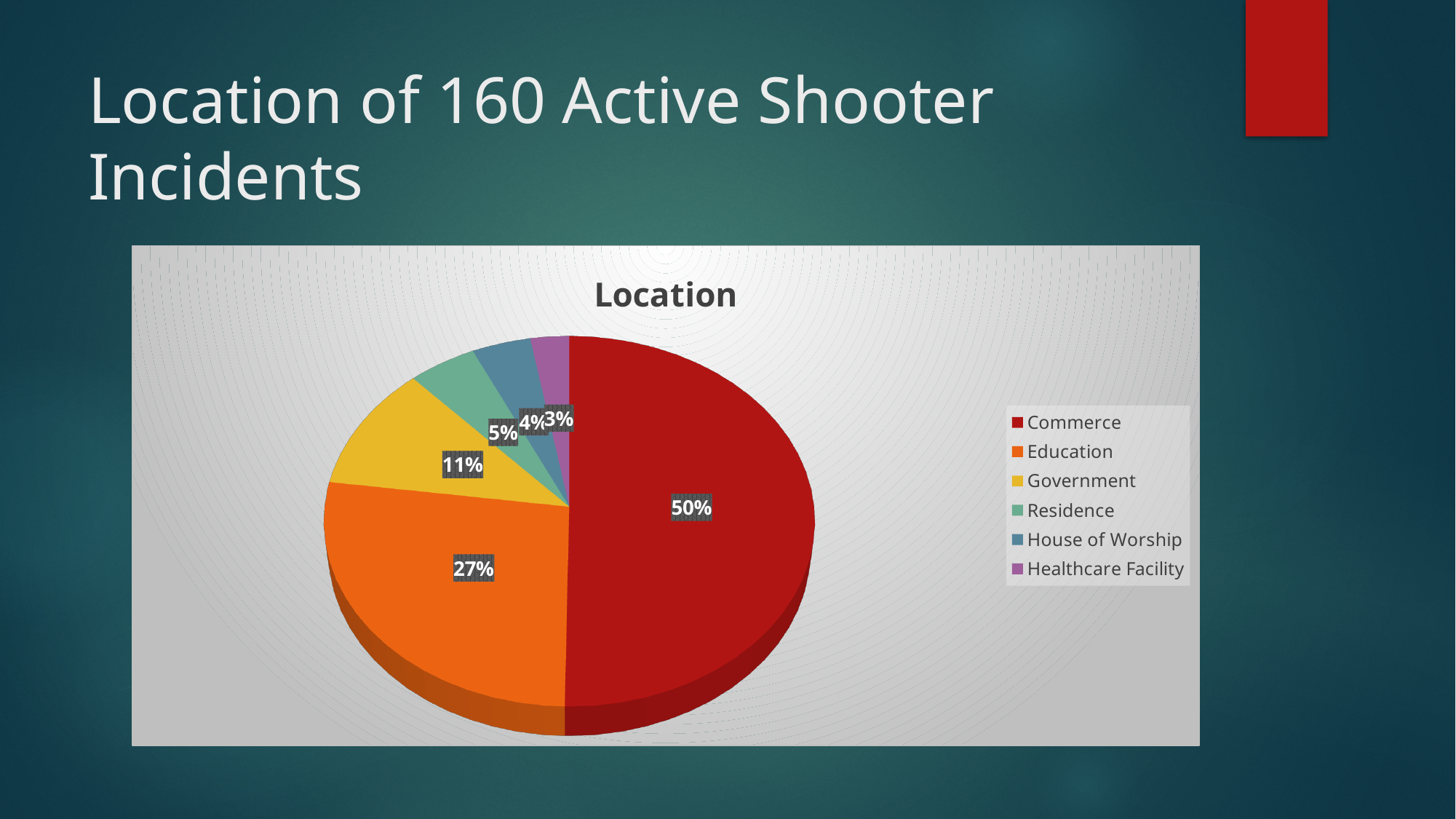
Which location category has the smallest slice of the pie? Healthcare Facility What percentage is shown for Education? 27% What percentage is shown for Healthcare Facility? 3% What percentage is shown for Residence? 5% What percentage is shown for Government? 11% How many categories does the legend list? 6 What percentage is shown for House of Worship? 4% What is the difference in percentage points between Commerce and Education? 23 What share of the pie does Commerce account for? 50% Which is larger, the Government slice or the Residence slice? Government Which location category has the largest slice of the pie? Commerce What type of chart is shown on the slide? Pie chart